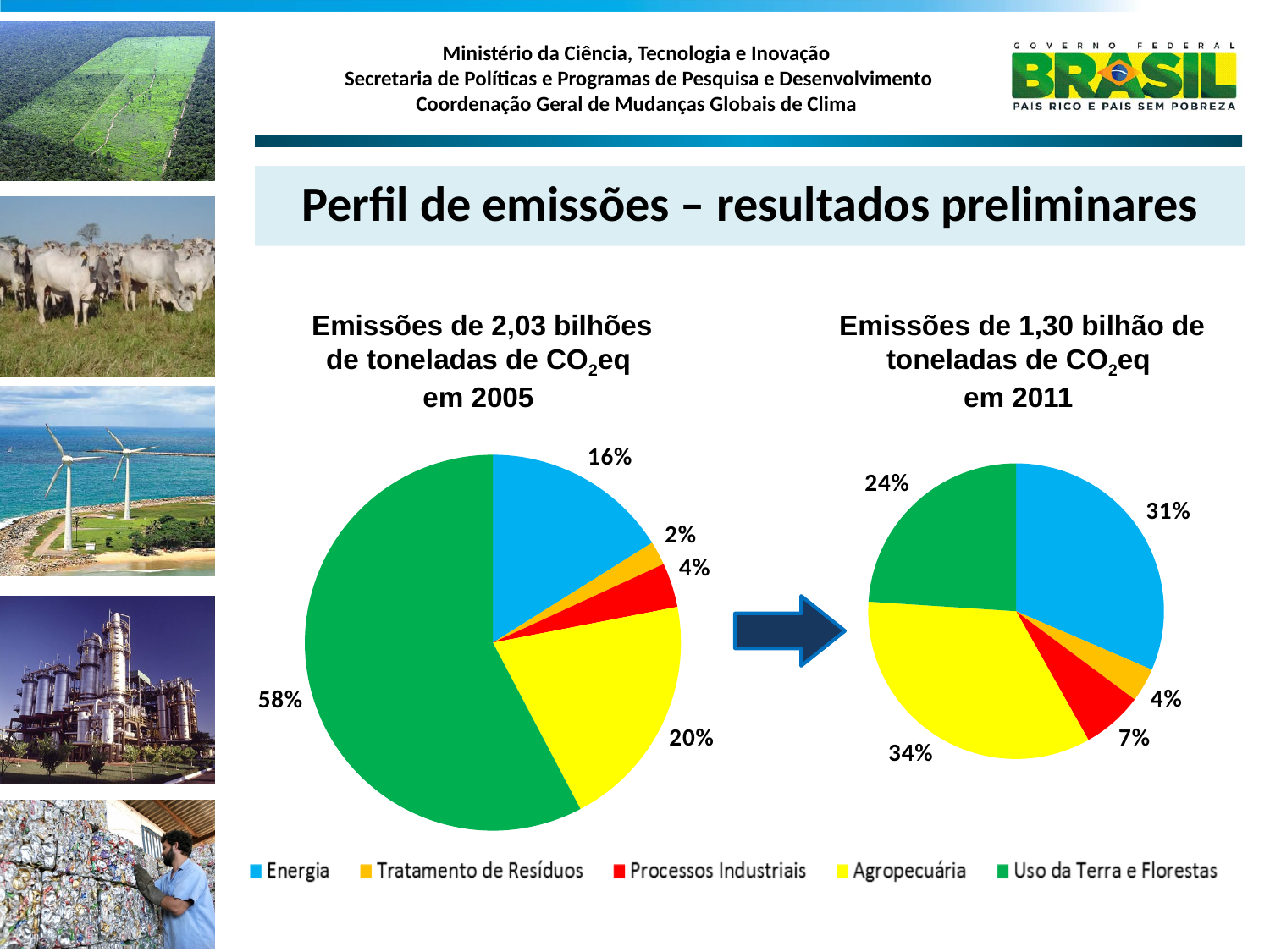
In the 2011 pie chart, which is larger: the share for Agropecuária or the share for Uso da Terra e Florestas? Agropecuária In the 2005 pie chart, which category has the largest share? Uso da Terra e Florestas In the 2011 pie chart, which category has the largest share? Agropecuária How many categories does the legend list for the pie charts? 5 In the 2005 pie chart, what share of emissions comes from Agropecuária? 20% What type of chart is used to show the 2005 emissions profile? Pie chart In the 2011 pie chart, what share of emissions comes from Energia? 31% In the 2005 pie chart, which category has the smallest share? Tratamento de Resíduos Which colour represents Agropecuária in the pie charts? Yellow In the 2005 pie chart, what share of emissions comes from Uso da Terra e Florestas? 58% What is the difference between the Energia share in 2011 and the Energia share in 2005? 15%